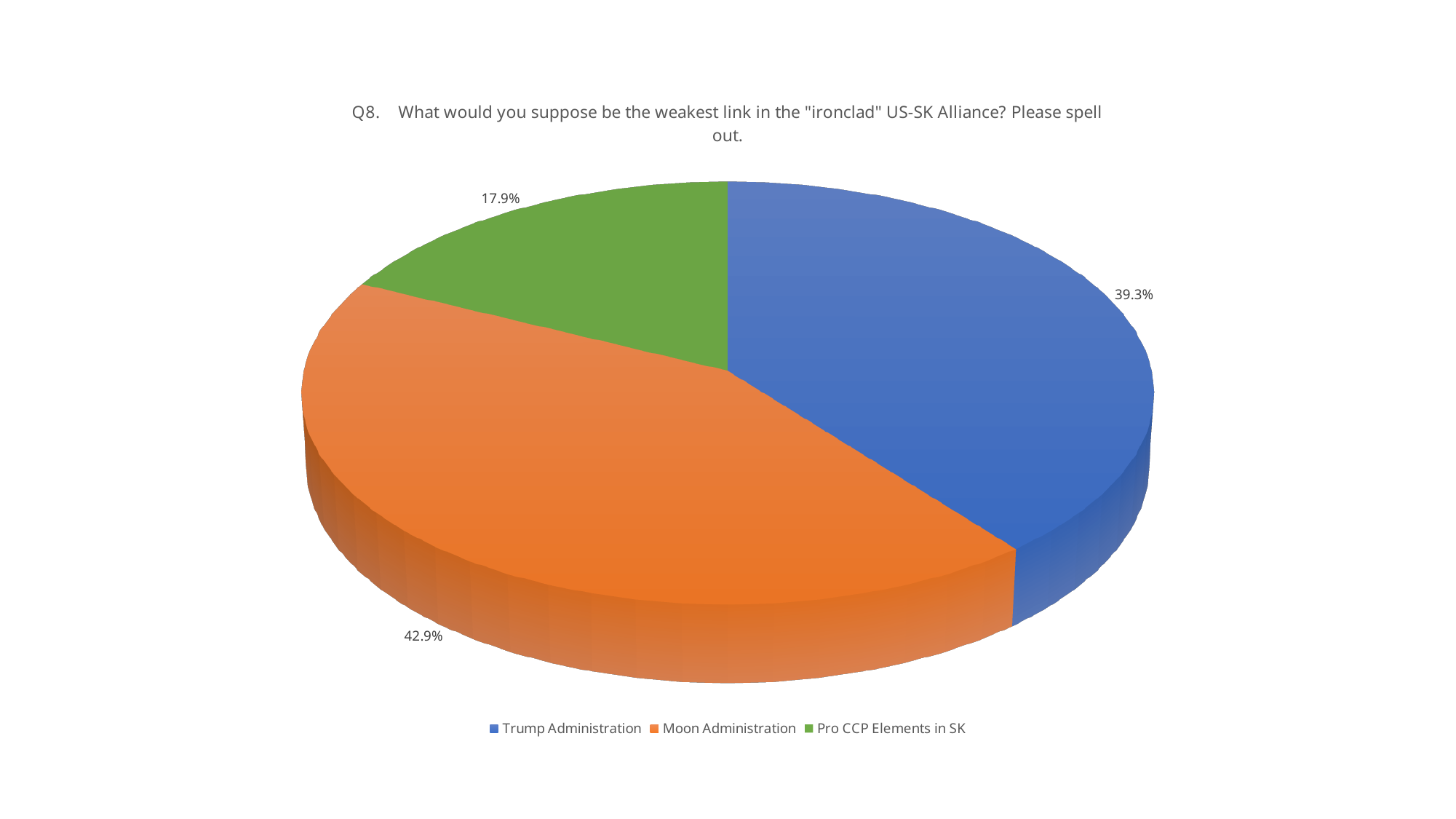
What percentage of the pie is labelled for Trump Administration? 39.3% Which slice is larger: Trump Administration or Pro CCP Elements in SK? Trump Administration What colour is the slice for Moon Administration? Orange What percentage of the pie is labelled for Moon Administration? 42.9% What percentage of the pie is labelled for Pro CCP Elements in SK? 17.9% What kind of chart is shown on the slide? Pie chart How many slices does the pie chart have? 3 What is the difference in percentage points between the Moon Administration and Trump Administration slices? 3.6 Which category does the green slice represent? Pro CCP Elements in SK Which category has the smallest share of the pie? Pro CCP Elements in SK What is the difference in percentage points between the Trump Administration and Pro CCP Elements in SK slices? 21.4 Which category has the largest share of the pie? Moon Administration